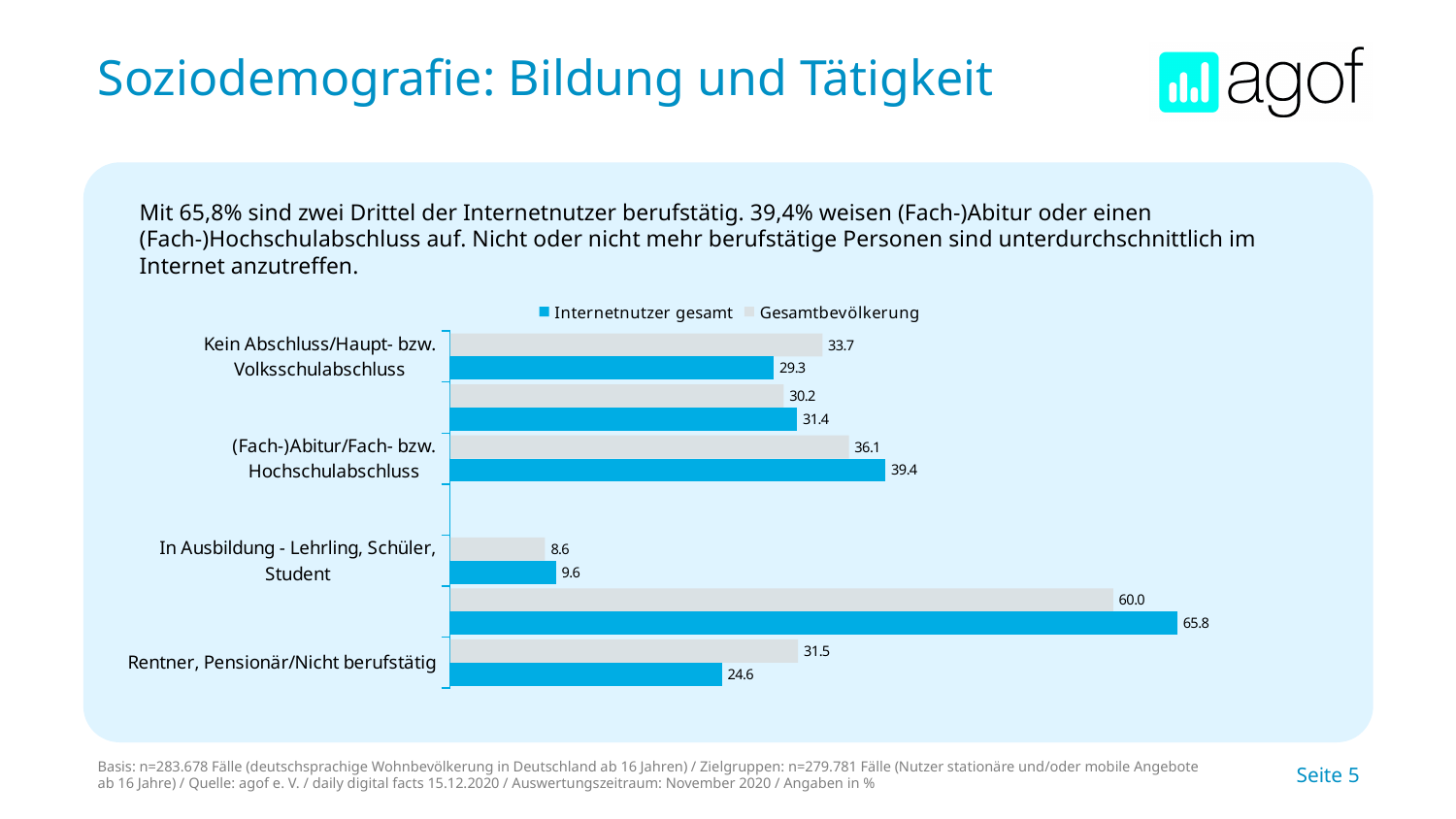
What is the value for Gesamtbevölkerung in the category "(Fach-)Abitur/Fach- bzw. Hochschulabschluss"? 36.1 How many series does the legend list? 2 In the category "In Ausbildung - Lehrling, Schüler, Student", which series has the larger value, Internetnutzer gesamt or Gesamtbevölkerung? Internetnutzer gesamt What is the difference between Gesamtbevölkerung and Internetnutzer gesamt in the category "Rentner, Pensionär/Nicht berufstätig"? 6.9 Which colour represents the series Internetnutzer gesamt in the chart? Blue What is the value for Internetnutzer gesamt in the category "(Fach-)Abitur/Fach- bzw. Hochschulabschluss"? 39.4 In the category "Kein Abschluss/Haupt- bzw. Volksschulabschluss", which series has the larger value, Internetnutzer gesamt or Gesamtbevölkerung? Gesamtbevölkerung What kind of chart is shown on the slide? Bar chart What is the difference between Internetnutzer gesamt and Gesamtbevölkerung in the category "(Fach-)Abitur/Fach- bzw. Hochschulabschluss"? 3.3 What is the value for Gesamtbevölkerung in the category "Rentner, Pensionär/Nicht berufstätig"? 31.5 What is the value for Internetnutzer gesamt in the category "In Ausbildung - Lehrling, Schüler, Student"? 9.6 What is the value for Internetnutzer gesamt in the category "Kein Abschluss/Haupt- bzw. Volksschulabschluss"? 29.3